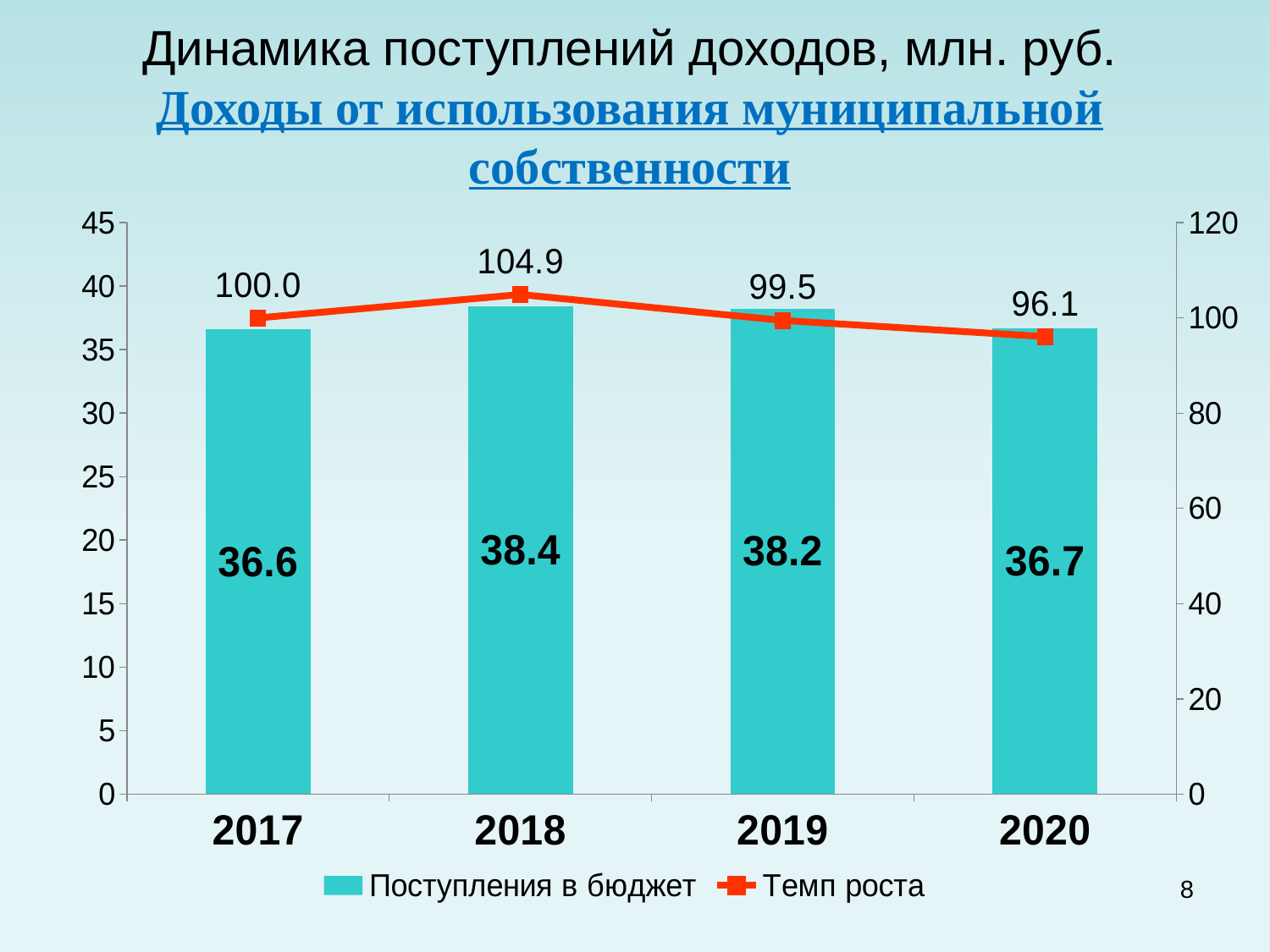
What colour are the bars for Поступления в бюджет? Turquoise Which is larger, Темп роста in 2018 or in 2019? 2018 How many years are shown on the x axis? 4 Does Темп роста rise or fall from 2018 to 2020? Fall What is the value of Темп роста for 2020? 96.1 Which year has the lowest value of Темп роста? 2020 How many series does the legend list? 2 What is the value of Поступления в бюджет for 2018? 38.4 What is the value of Поступления в бюджет for 2017? 36.6 What is the difference between Поступления в бюджет in 2018 and in 2020? 1.7 Which year has the highest value of Поступления в бюджет? 2018 What kind of chart is shown on the slide? Combined bar and line chart